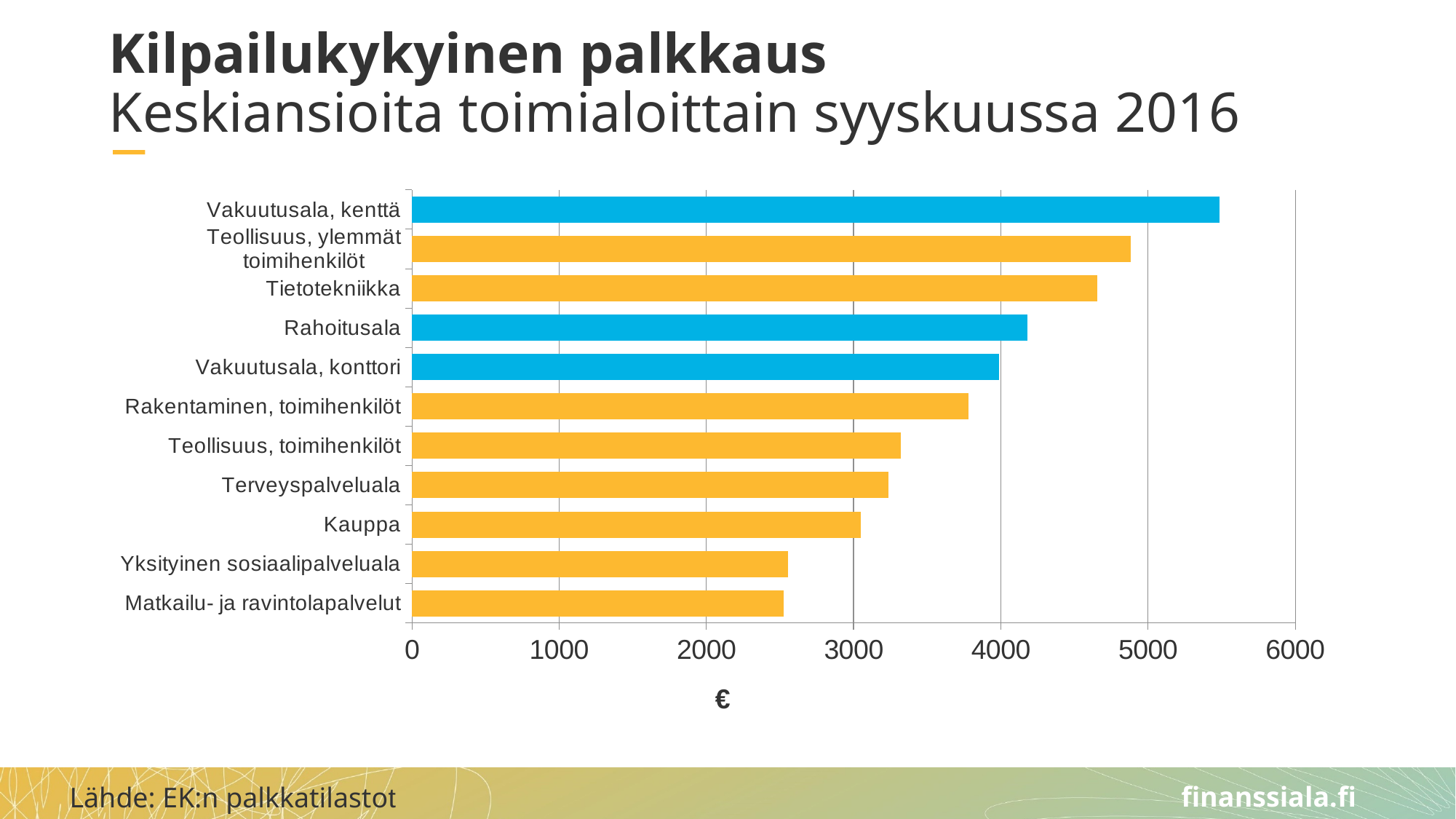
How many industry categories are plotted in the chart? 11 Is the value for Yksityinen sosiaalipalveluala greater or less than 3000? less Is the value for Vakuutusala, kenttä greater or less than 5000? greater What unit is shown on the x axis of the chart? € Which category has the highest average earnings in the chart? Vakuutusala, kenttä Is the value for Teollisuus, toimihenkilöt greater or less than 3000? greater Which is larger, the value for Terveyspalveluala or the value for Kauppa? Terveyspalveluala What kind of chart is shown on the slide? bar chart Which is larger, the value for Tietotekniikka or the value for Rahoitusala? Tietotekniikka